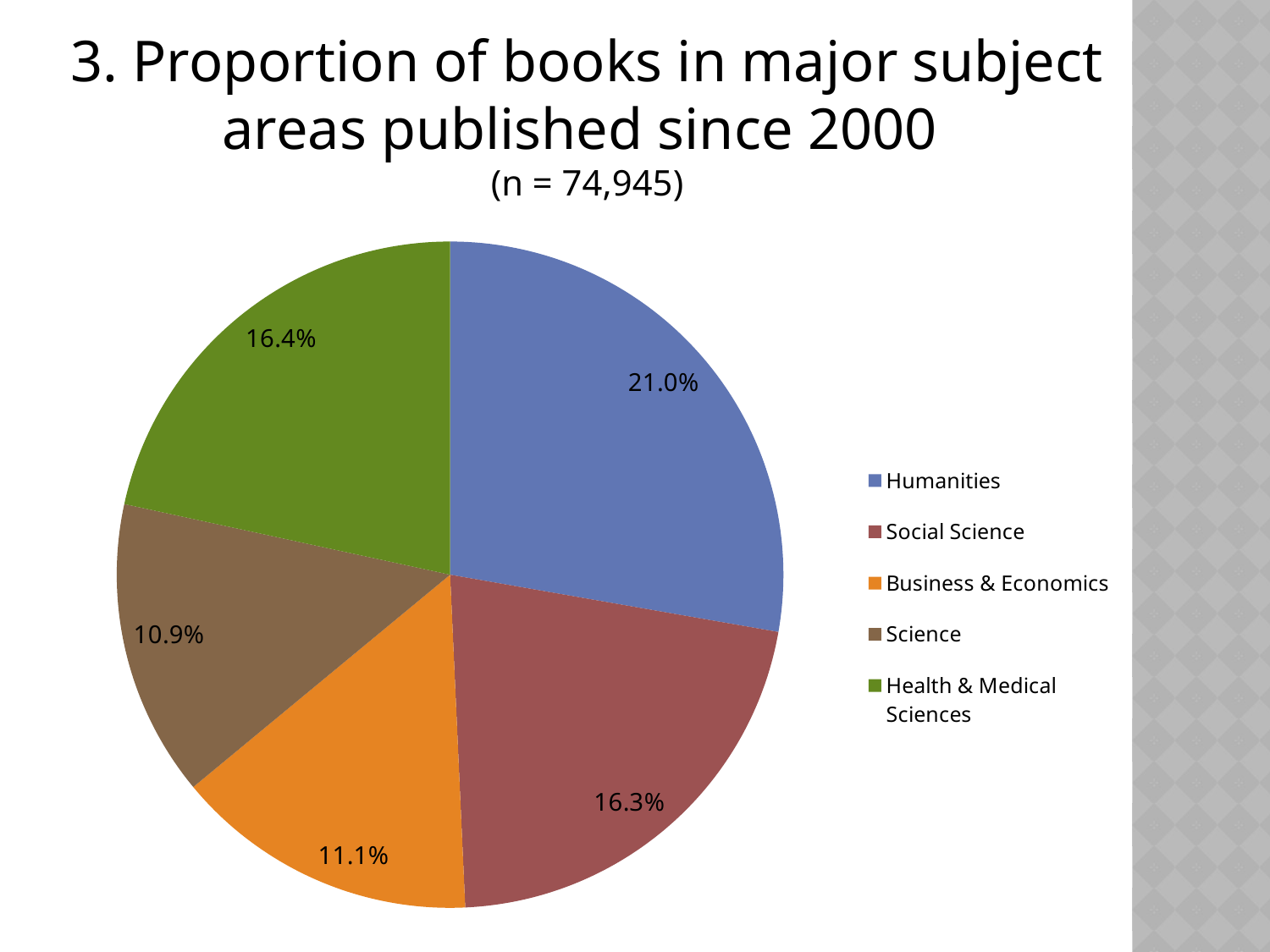
How many subject areas are shown in the pie chart? 5 What is the value shown for Science? 10.9% Which is larger, the share for Humanities or the share for Social Science? Humanities What kind of chart is shown on the slide? Pie chart What percentage is shown for Business & Economics? 11.1% What is the difference in percentage points between Humanities and Science? 10.1 What percentage of the pie does Humanities account for? 21.0% Which is larger, the share for Health & Medical Sciences or the share for Business & Economics? Health & Medical Sciences Which subject area has the largest share of the pie? Humanities What percentage is shown for Health & Medical Sciences? 16.4% What is the value shown for Social Science? 16.3% What sample size (n) is given in the chart title? 74,945